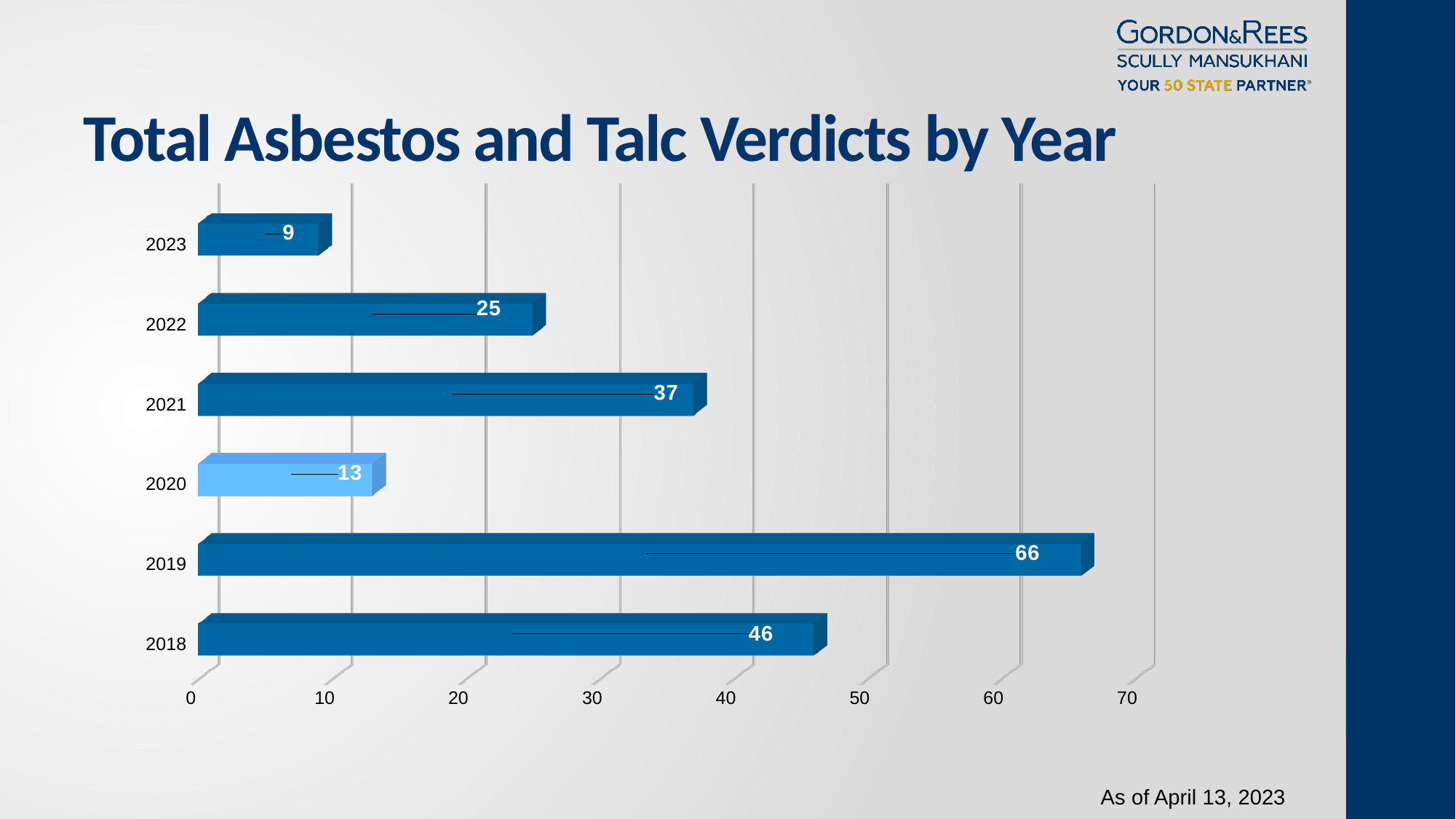
Which year has the lowest number of verdicts? 2023 What is the title of the chart? Total Asbestos and Talc Verdicts by Year What is the value shown for 2023? 9 How many years are shown on the chart? 6 Which year had more verdicts, 2022 or 2020? 2022 How many verdicts are shown for 2021? 37 What is the difference between the verdicts in 2021 and 2020? 24 Which year has the highest number of verdicts? 2019 What is the difference between the verdicts in 2019 and 2018? 20 What kind of chart is shown on the slide? Bar chart Is the value for 2018 greater or less than 40? greater What is the total number of asbestos and talc verdicts in 2019? 66